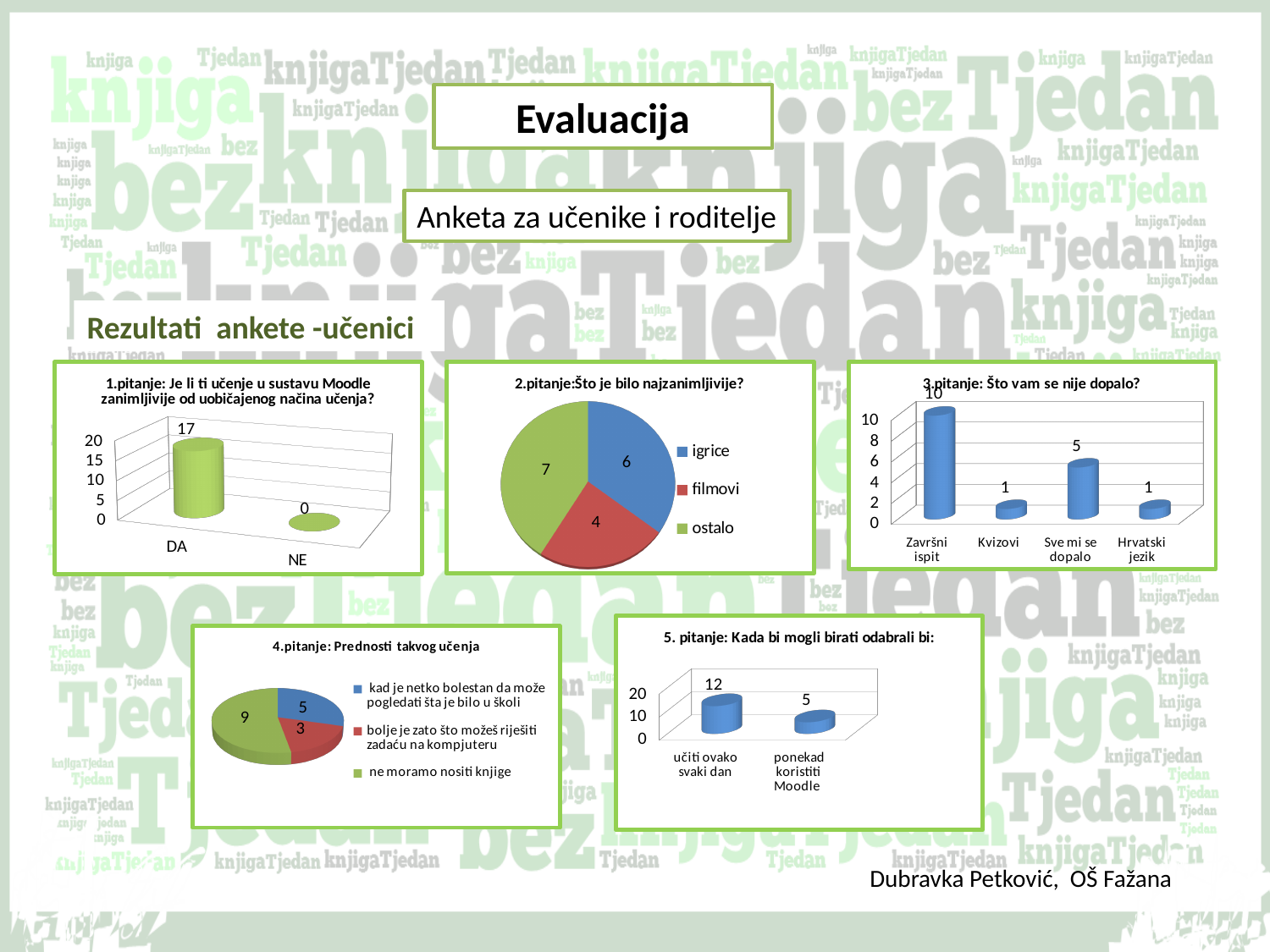
In the chart titled "4.pitanje: Prednosti takvog učenja", how many entries does the legend list? 3 In the chart titled "1.pitanje: Je li ti učenje u sustavu Moodle zanimljivije od uobičajenog načina učenja?", what is the value for DA? 17 In the chart titled "5. pitanje: Kada bi mogli birati odabrali bi:", what is the value for "učiti ovako svaki dan"? 12 In the chart titled "3.pitanje: Što vam se nije dopalo?", how many categories are shown on the x axis? 4 In the chart titled "4.pitanje: Prednosti takvog učenja", what is the value for "ne moramo nositi knjige"? 9 In the chart titled "5. pitanje: Kada bi mogli birati odabrali bi:", which is larger, "učiti ovako svaki dan" or "ponekad koristiti Moodle"? učiti ovako svaki dan In the chart titled "2.pitanje:Što je bilo najzanimljivije?", what kind of chart is shown? pie chart In the chart titled "1.pitanje" (top left), what is the value for NE? 0 In the chart titled "3.pitanje: Što vam se nije dopalo?", what is the difference between Završni ispit and Sve mi se dopalo? 5 In the chart titled "2.pitanje:Što je bilo najzanimljivije?", what is the value for filmovi? 4 In the chart titled "2.pitanje:Što je bilo najzanimljivije?", which category has the largest slice? ostalo In the chart titled "3.pitanje: Što vam se nije dopalo?", what is the value for Završni ispit? 10